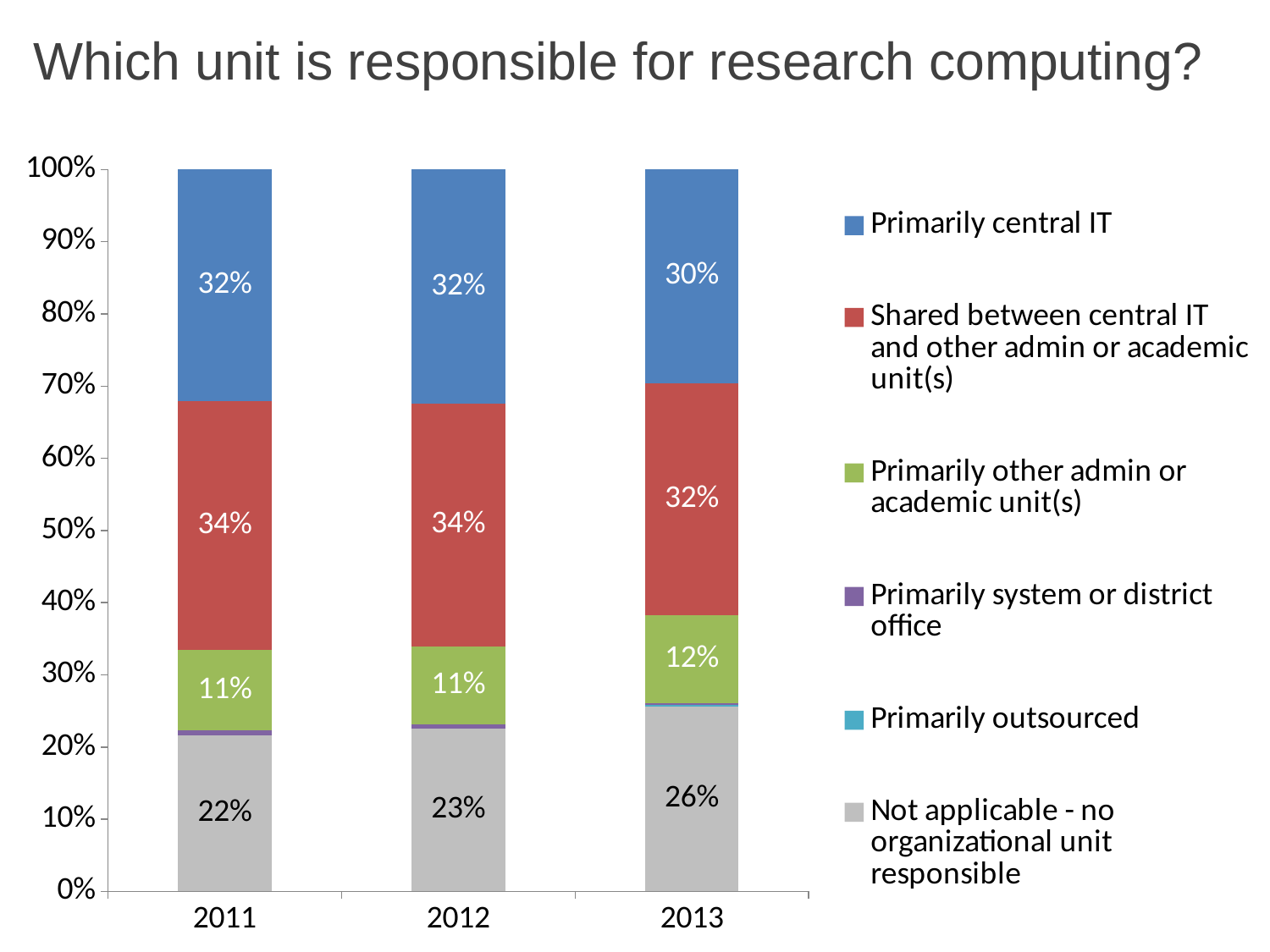
How many years are shown on the x axis? 3 What is the value for "Primarily other admin or academic unit(s)" in 2013? 12% Which is larger in 2012: the "Primarily central IT" share or the "Shared between central IT and other admin or academic unit(s)" share? Shared between central IT and other admin or academic unit(s) What is the value for "Not applicable - no organizational unit responsible" in 2012? 23% What is the value for "Shared between central IT and other admin or academic unit(s)" in 2011? 34% How many series does the legend list? 6 In which year is the "Not applicable - no organizational unit responsible" share the highest? 2013 By how many percentage points did the "Not applicable - no organizational unit responsible" share change from 2011 to 2013? 4 percentage points What kind of chart is shown on the slide? Stacked bar chart In which year is the "Primarily central IT" share the lowest? 2013 What percentage of respondents in 2013 said research computing is primarily the responsibility of central IT? 30% Does the "Not applicable - no organizational unit responsible" share rise or fall from 2011 to 2013? Rise